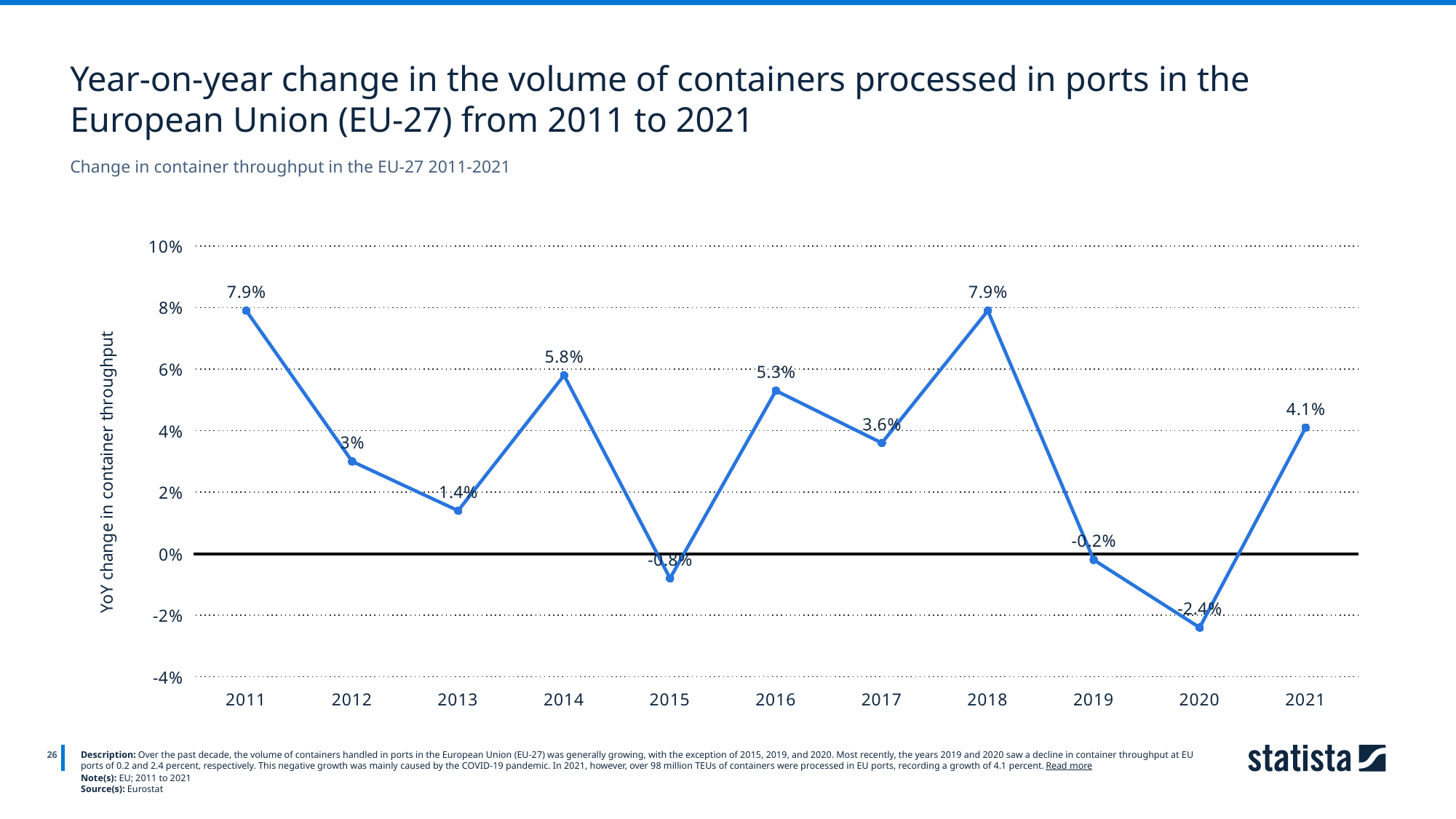
How many years are plotted on the chart? 11 What is the highest value plotted on the chart? 7.9% Do the values rise or fall from 2018 to 2020? Fall What is the year-on-year change in container throughput for 2014? 5.8% What is the difference between the values for 2014 and 2013? 4.4 percentage points What is the difference between the values for 2021 and 2020? 6.5 percentage points Which year has the larger value, 2016 or 2017? 2016 What is the year-on-year change shown for 2021? 4.1% Which year has the lowest year-on-year change? 2020 What value is plotted for 2015? -0.8% What value is shown for 2020? -2.4% What kind of chart is shown on the slide? Line chart